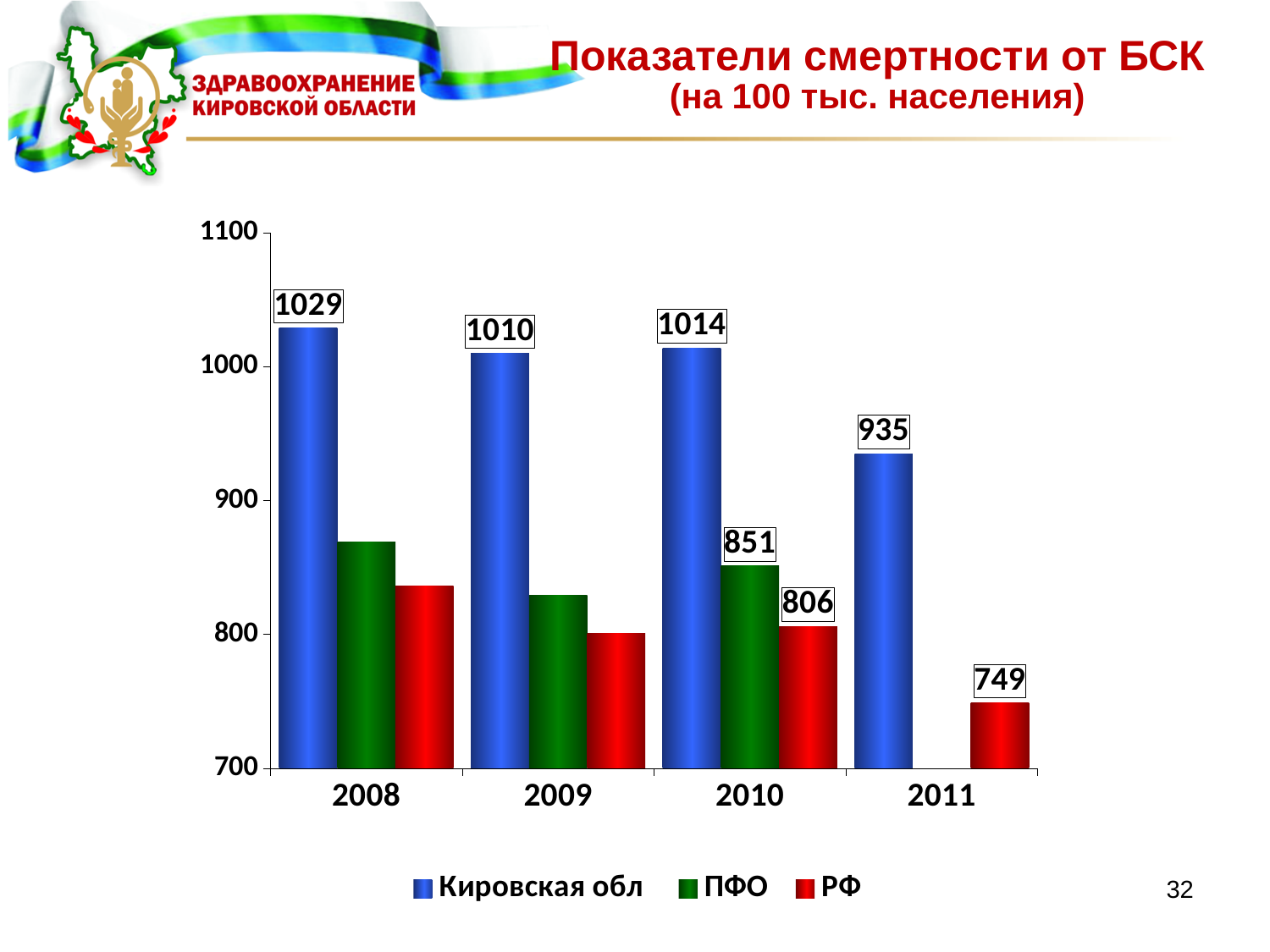
How many series does the legend list? 3 What is the value for ПФО in 2010? 851 How many years are shown on the x axis? 4 In which year is the value for Кировская обл the lowest? 2011 In 2010, what is the difference between the Кировская обл value and the ПФО value? 163 In 2010, which is larger: the value for ПФО or the value for РФ? ПФО Is the value for ПФО in 2008 greater or less than 900? less In which year is the value for Кировская обл the highest? 2008 What is the value for Кировская обл in 2011? 935 What is the value for Кировская обл in 2008? 1029 What is the difference between the Кировская обл values in 2008 and 2011? 94 What is the value for РФ in 2011? 749